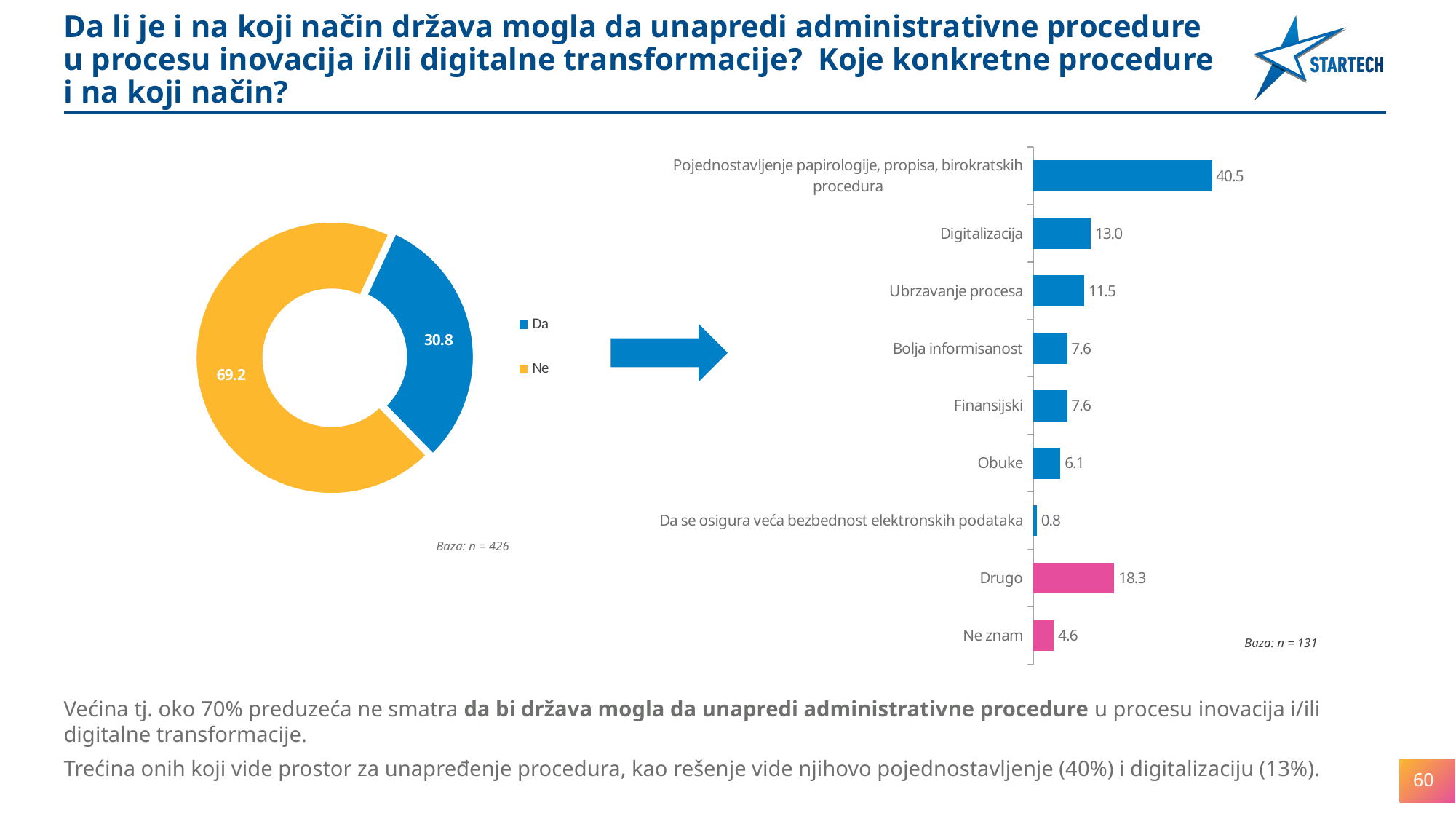
In the bar chart on the right, what is the value for "Digitalizacija"? 13.0 In the bar chart on the right, what is the difference between the values for "Digitalizacija" and "Ubrzavanje procesa"? 1.5 In the bar chart on the right, which category has the lowest value? Da se osigura veća bezbednost elektronskih podataka In the bar chart on the right, how many categories are shown? 9 In the doughnut chart on the left, which category has the larger share, "Da" or "Ne"? Ne In the bar chart on the right, which category has the highest value? Pojednostavljenje papirologije, propisa, birokratskih procedura In the doughnut chart on the left, what is the value for "Da"? 30.8 What kind of chart is shown on the right of the slide? Bar chart In the doughnut chart on the left, how many entries does the legend list? 2 In the doughnut chart on the left, what is the value for "Ne"? 69.2 What kind of chart is shown on the left of the slide? Doughnut (pie) chart In the bar chart on the right, what is the value for "Drugo"? 18.3